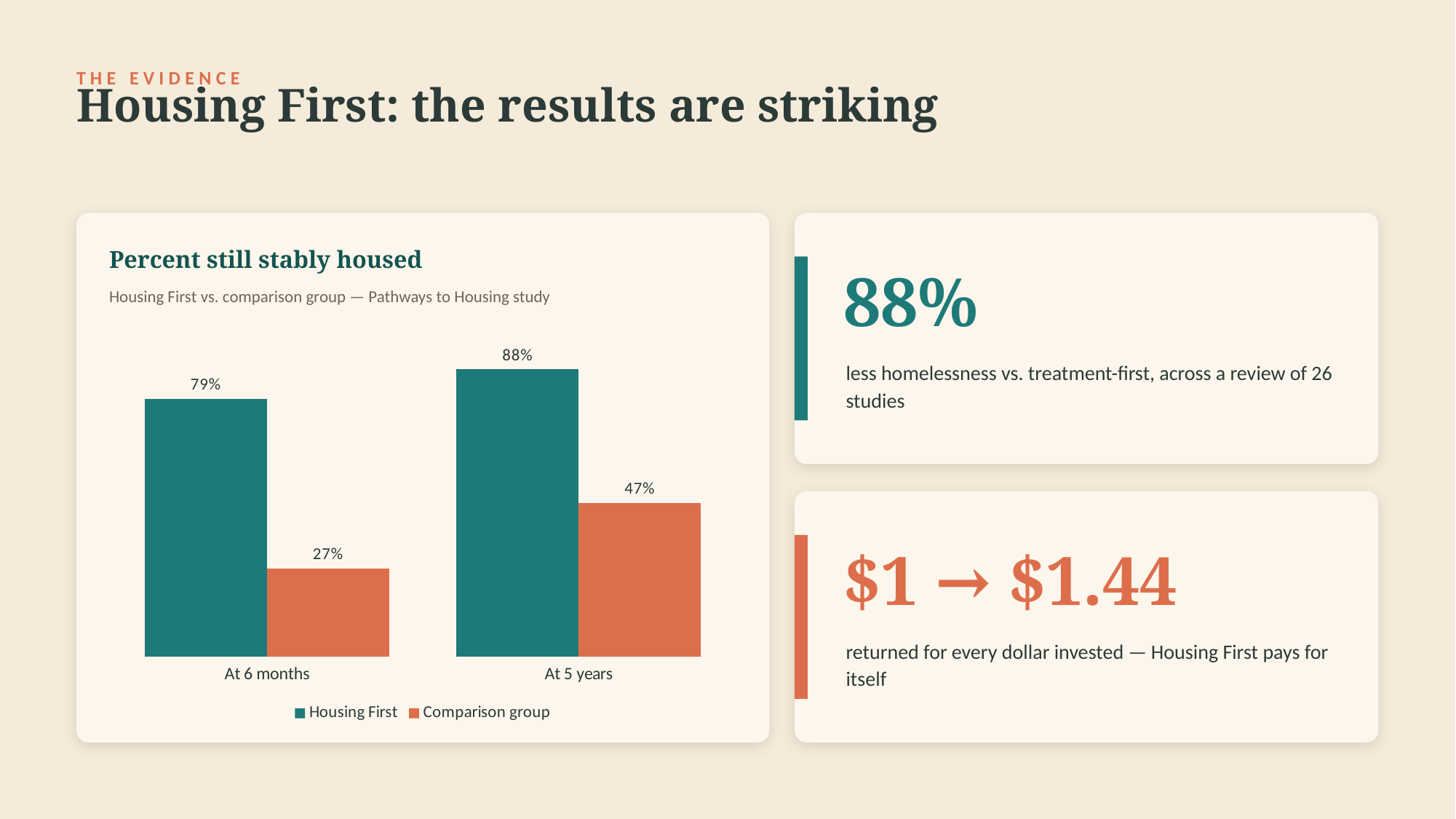
What is the difference between Housing First and the Comparison group at 5 years? 41% What is the value for the Comparison group at 6 months? 27% Which bar has the lowest value in the chart? Comparison group at 6 months What is the value for the Comparison group at 5 years? 47% How many series does the legend list? 2 What kind of chart is shown on the slide? Bar chart What is the value for Housing First at 5 years? 88% What is the difference between Housing First and the Comparison group at 6 months? 52% What is the value for Housing First at 6 months? 79% Which is larger at 5 years, Housing First or the Comparison group? Housing First Which series has the highest value in the chart? Housing First How many categories are shown on the x axis of the chart? 2